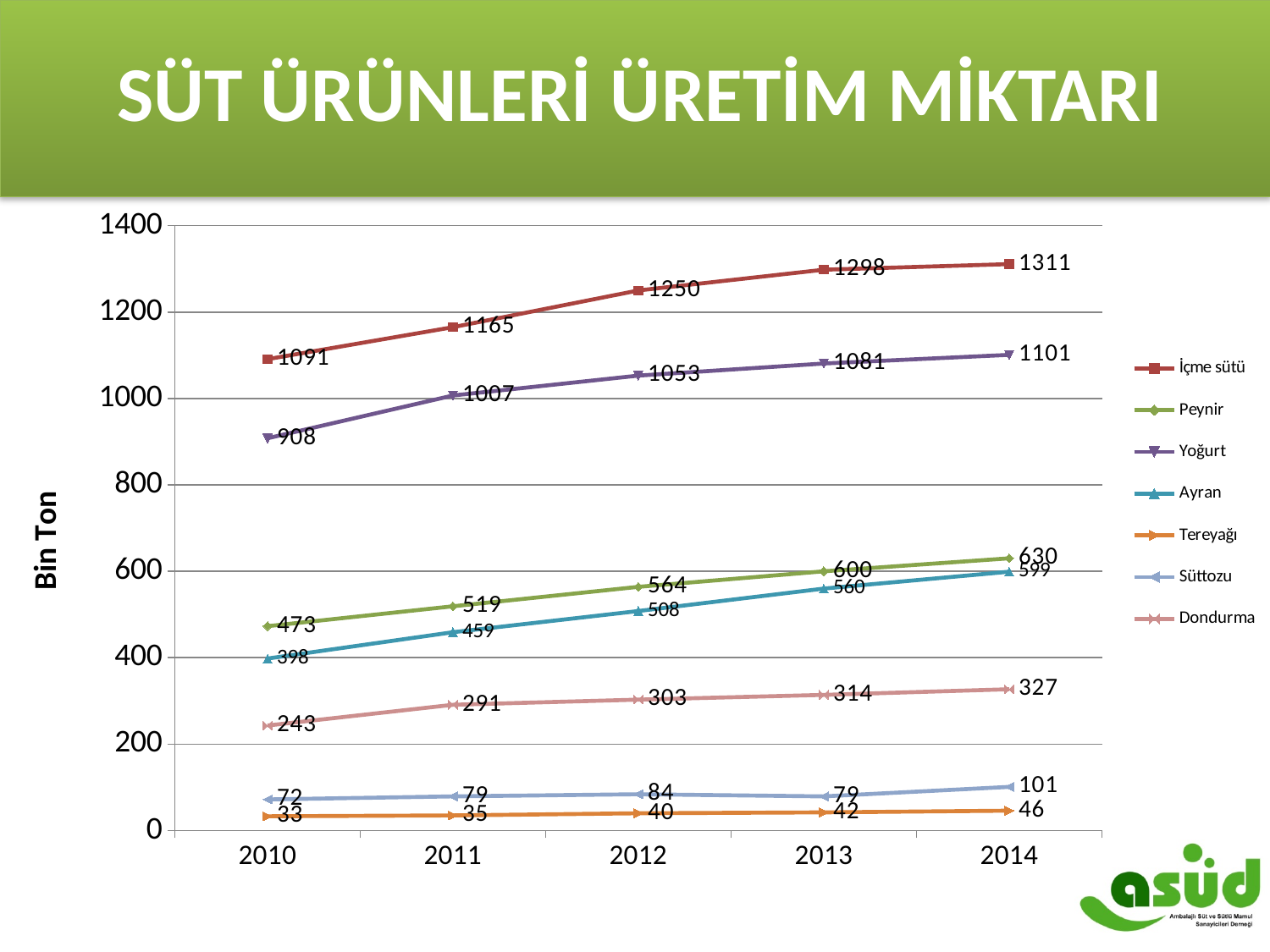
How many years are shown on the x axis? 5 Does the Peynir series rise or fall from 2010 to 2014? Rise What is the value for Dondurma in 2010? 243 What is the value for Yoğurt in 2011? 1007 What is the difference between the İçme sütü values in 2014 and 2010? 220 What kind of chart is shown on the slide? Line chart What is the value for Ayran in 2012? 508 Which series has the highest value in 2014? İçme sütü What is the value for İçme sütü in 2014? 1311 Which series has the lowest value in 2010? Tereyağı How many series does the legend list? 7 Which is larger in 2013, Peynir or Ayran? Peynir